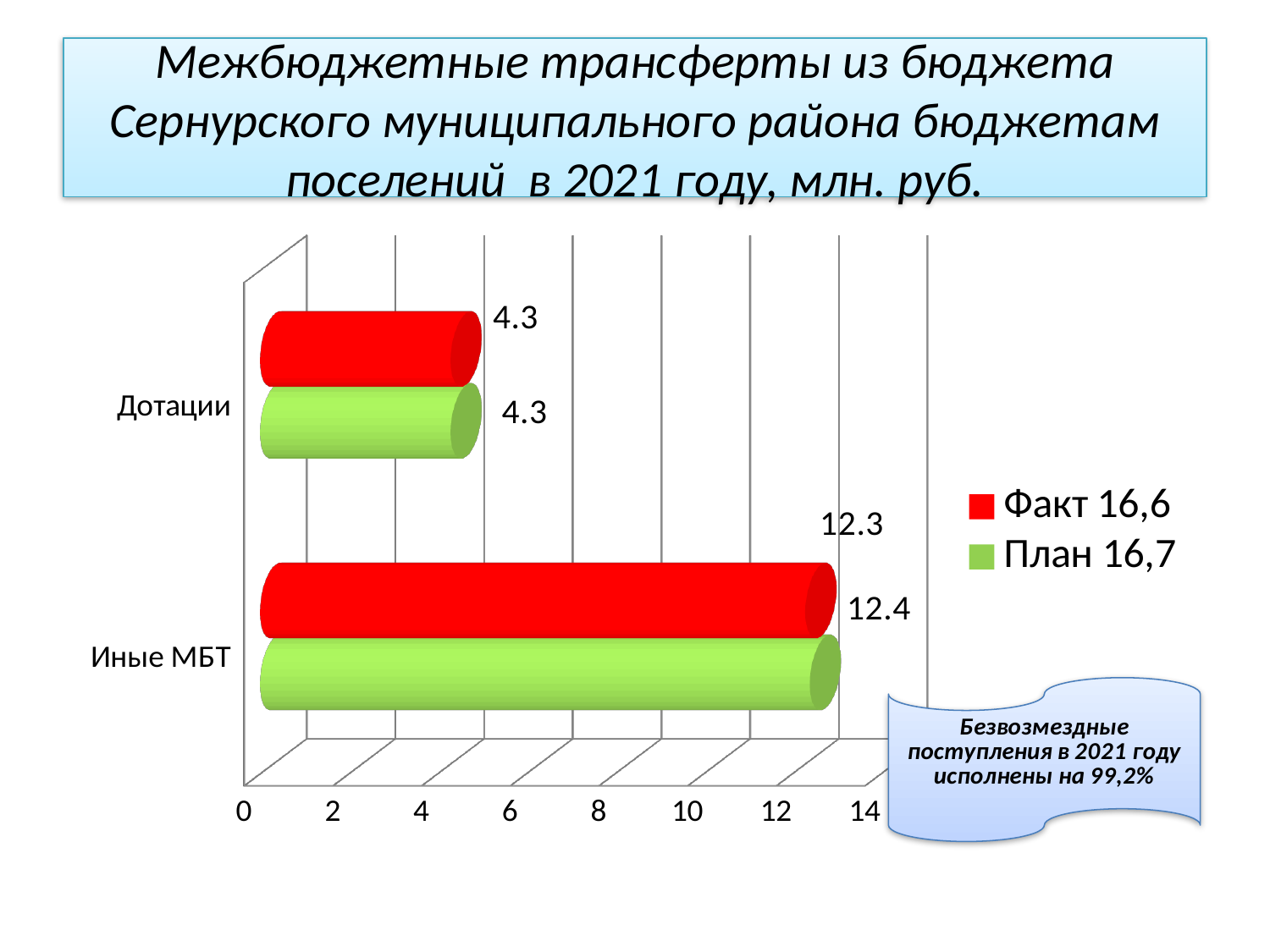
How many categories are shown on the chart? 2 What is the Факт value for Дотации? 4.3 Which is larger: the Факт value for Иные МБТ or the Факт value for Дотации? Иные МБТ What is the difference between the Факт values for Иные МБТ and Дотации? 8 What is the difference between the План and Факт values for Иные МБТ? 0.1 What is the План value for Дотации? 4.3 Which category has the lowest План value? Дотации How many series does the legend list? 2 What kind of chart is shown on the slide? Bar chart Which category has the highest Факт value? Иные МБТ What is the Факт value for Иные МБТ? 12.3 What is the План value for Иные МБТ? 12.4